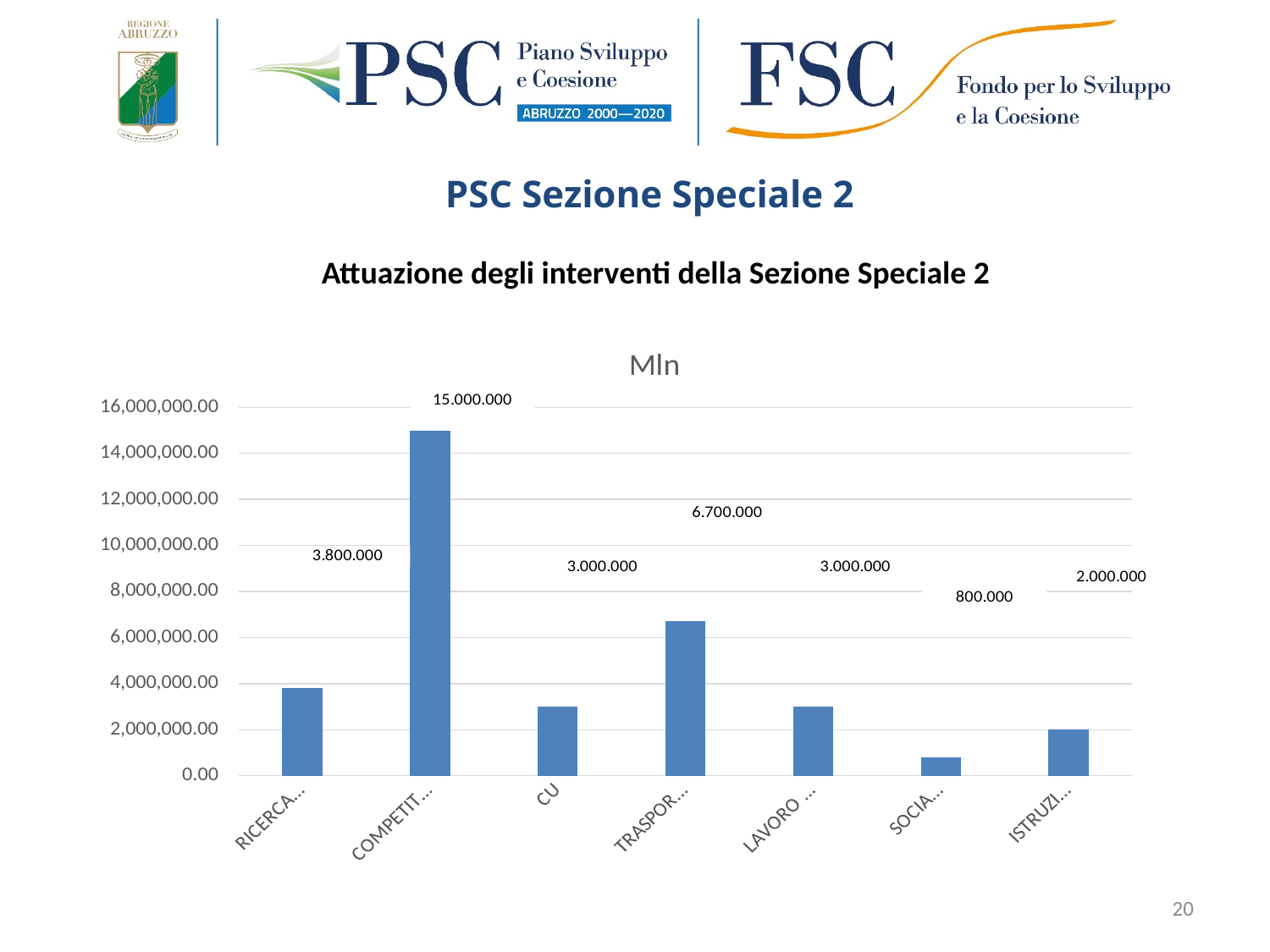
How many categories are plotted in the chart? 7 What kind of chart is shown on the slide? bar chart Is the value for the second bar (COMPETIT…) greater or less than 14,000,000.00? greater What is the value shown for the category CU? 3.000.000 Which is larger, the value for RICERCA… or the value for CU? RICERCA… What is the value shown for the category labelled TRASPOR…? 6.700.000 Which category has the lowest value in the chart? SOCIA… What is the title of the chart? Mln What is the difference between the value for RICERCA… and the value for ISTRUZI…? 1.800.000 Which category has the highest value in the chart? COMPETIT… What is the difference between the value for COMPETIT… and the value for TRASPOR…? 8.300.000 What is the value shown for the category labelled ISTRUZI…? 2.000.000